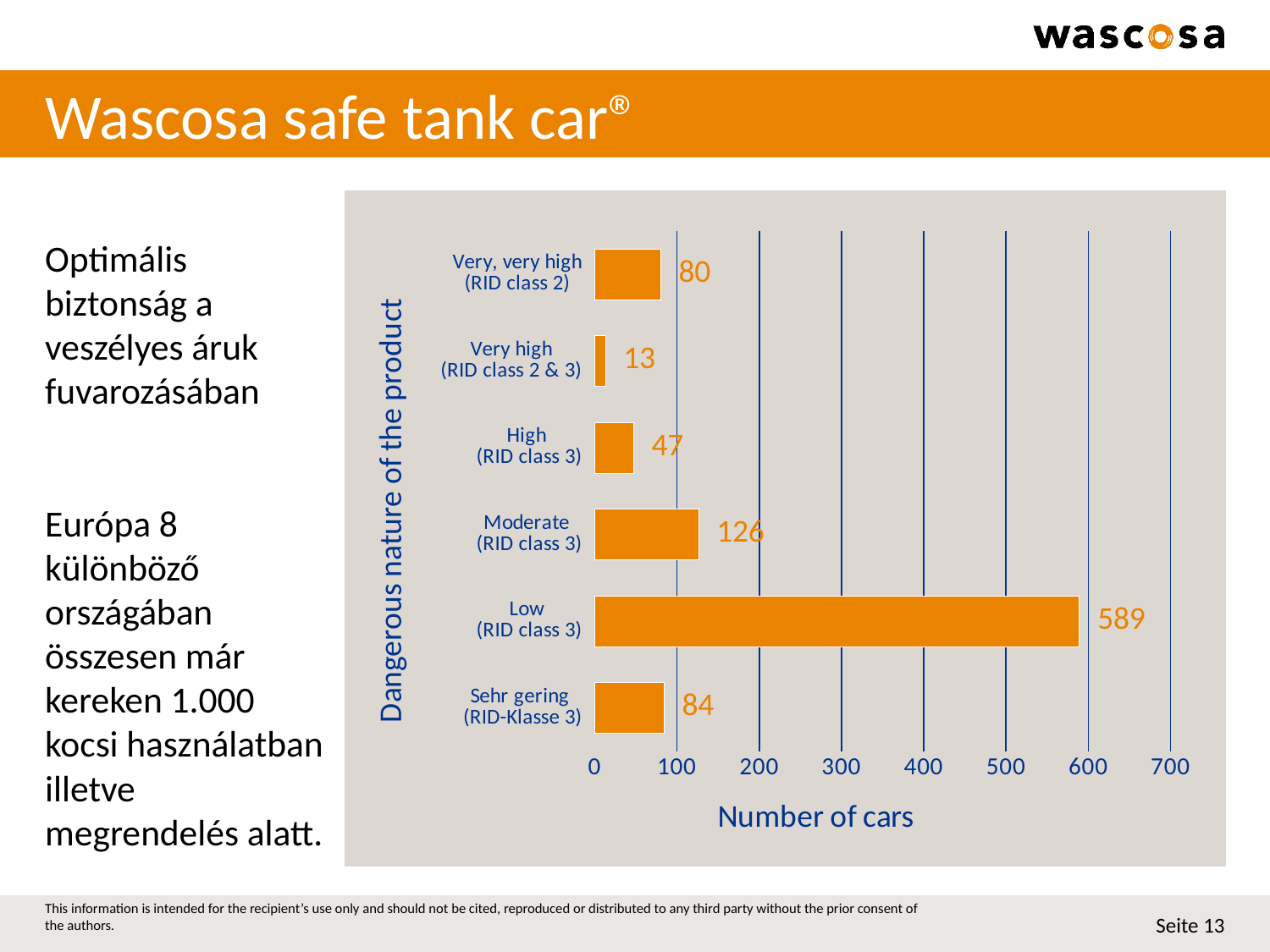
Which category has the lowest number of cars? Very high (RID class 2 & 3) What is the difference in number of cars between 'Low (RID class 3)' and 'Moderate (RID class 3)'? 463 What is the label of the horizontal axis of the chart? Number of cars Is the value for 'Low (RID class 3)' greater or less than 500? greater What kind of chart is shown on the slide? Bar chart How many categories are shown on the chart? 6 What is the number of cars for the 'Moderate (RID class 3)' category? 126 What is the number of cars for the 'Low (RID class 3)' category? 589 What is the number of cars for the 'Sehr gering (RID-Klasse 3)' category? 84 Which category has the highest number of cars? Low (RID class 3) Which has more cars: 'Very, very high (RID class 2)' or 'High (RID class 3)'? Very, very high (RID class 2) What is the number of cars for the 'Very high (RID class 2 & 3)' category? 13